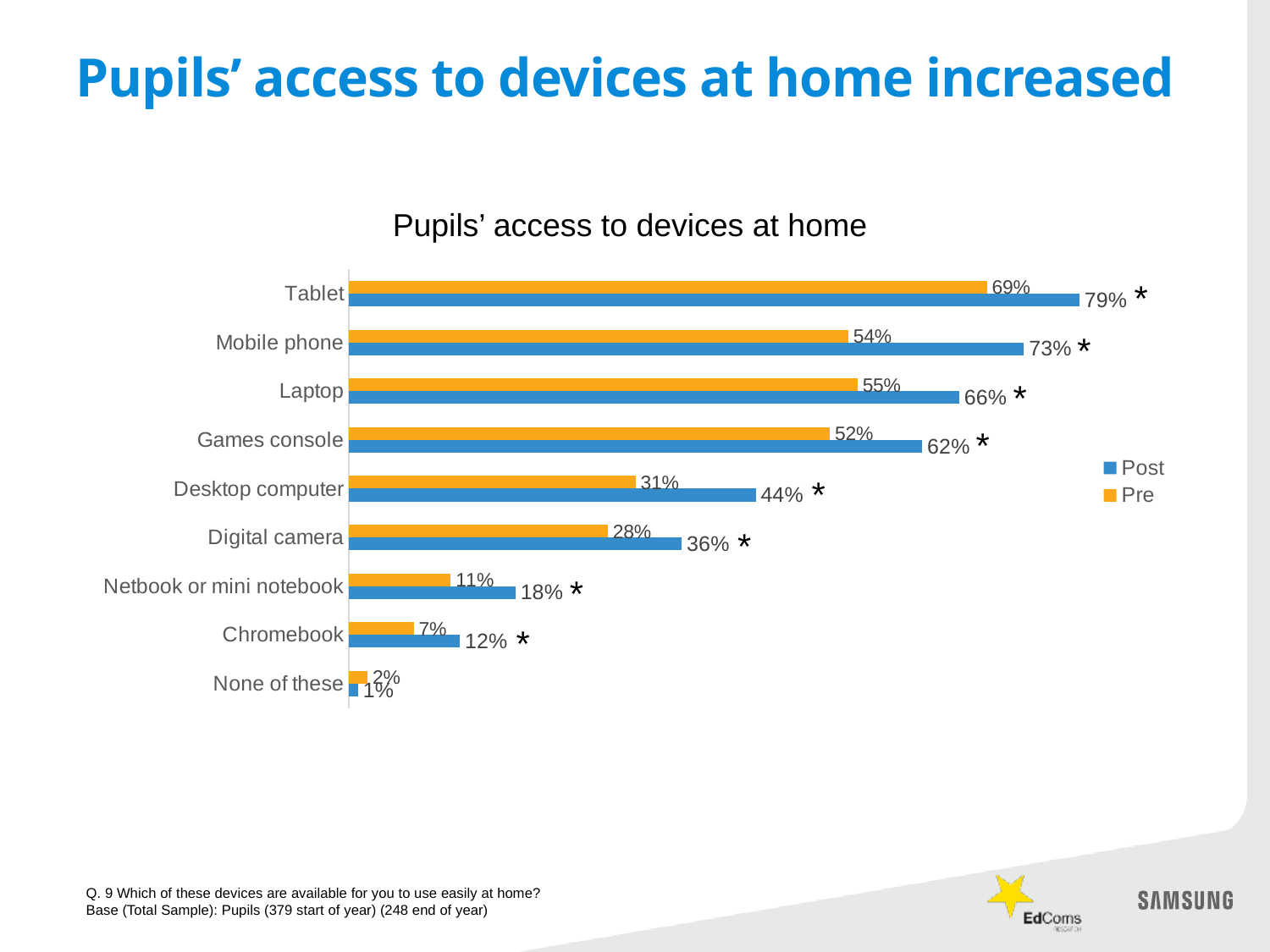
What is the Pre value for Mobile phone? 54% What is the difference between the Post values for Laptop and Games console? 4% What is the difference between the Post and Pre values for Mobile phone? 19% What type of chart is shown? Bar chart Which category has the lowest Pre value? None of these What is the Pre value for Chromebook? 7% What is the Post value for Tablet? 79% How many series does the legend list? 2 Which device has the highest Post value? Tablet How many device categories are shown on the chart? 9 What is the Post value for Desktop computer? 44% Which is larger, the Pre value for Laptop or the Pre value for Mobile phone? Laptop